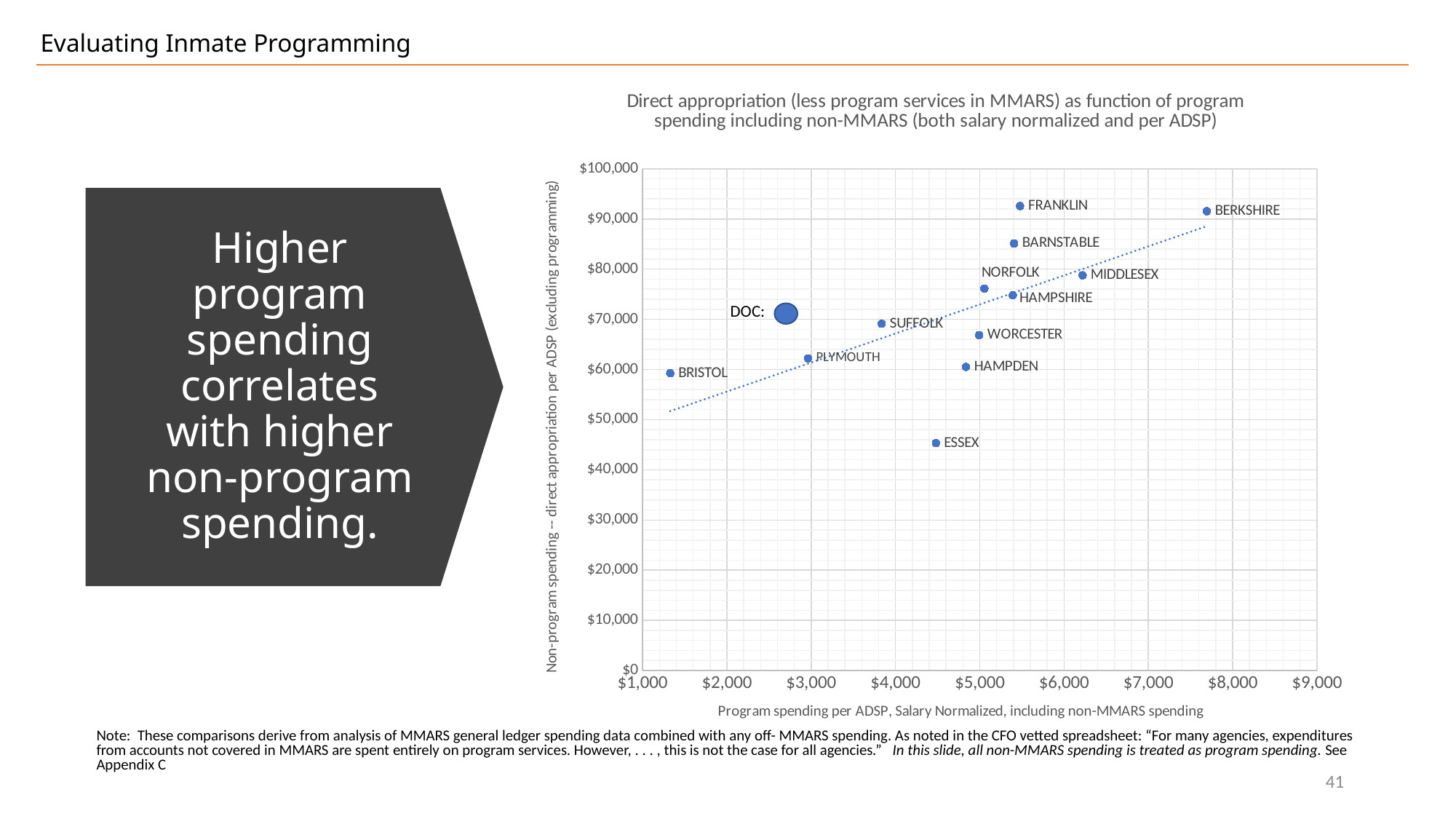
Is the program spending per ADSP for BERKSHIRE greater or less than $7,000? greater Does the dotted trend line rise or fall as program spending per ADSP increases? Rises What is the label of the x axis? Program spending per ADSP, Salary Normalized, including non-MMARS spending Is the non-program spending value for ESSEX greater or less than $50,000? less What kind of chart is shown on the slide? Scatter chart Is the program spending per ADSP for PLYMOUTH greater or less than $4,000? less Which labeled point has the lowest program spending per ADSP (furthest left)? BRISTOL Which labeled point has the highest program spending per ADSP (furthest right)? BERKSHIRE Which has higher non-program spending per ADSP, HAMPDEN or ESSEX? HAMPDEN Which labeled point has the lowest non-program spending per ADSP? ESSEX Which has higher non-program spending per ADSP, NORFOLK or WORCESTER? NORFOLK